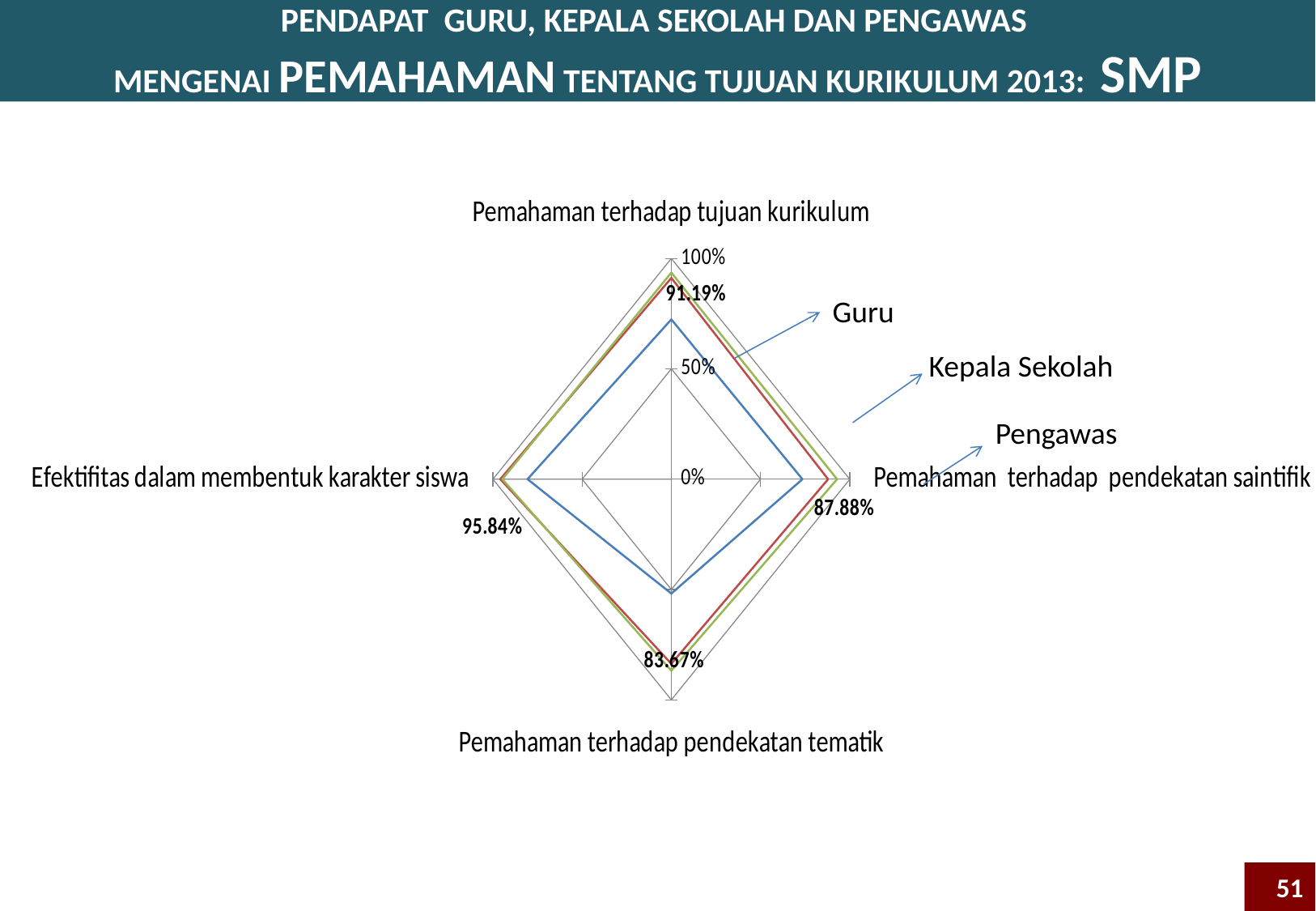
Is the blue series' value on the 'Pemahaman terhadap tujuan kurikulum' axis greater or less than 50%? greater What value is printed on the 'Pemahaman terhadap pendekatan saintifik' axis? 87.88% What value is printed on the 'Pemahaman terhadap pendekatan tematik' axis? 83.67% What value is printed on the 'Pemahaman terhadap tujuan kurikulum' axis? 91.19% What value is printed on the 'Efektifitas dalam membentuk karakter siswa' axis? 95.84% What kind of chart is shown on the slide? Radar chart Which axis has the lowest printed value? Pemahaman terhadap pendekatan tematik Which axis has the highest printed value? Efektifitas dalam membentuk karakter siswa What is the difference between the printed values for 'Efektifitas dalam membentuk karakter siswa' and 'Pemahaman terhadap pendekatan tematik'? 12.17% How many series (respondent groups) are shown on the chart? 3 Which three respondent groups are labelled on the chart? Guru, Kepala Sekolah, Pengawas How many axes (categories) does the radar chart have? 4